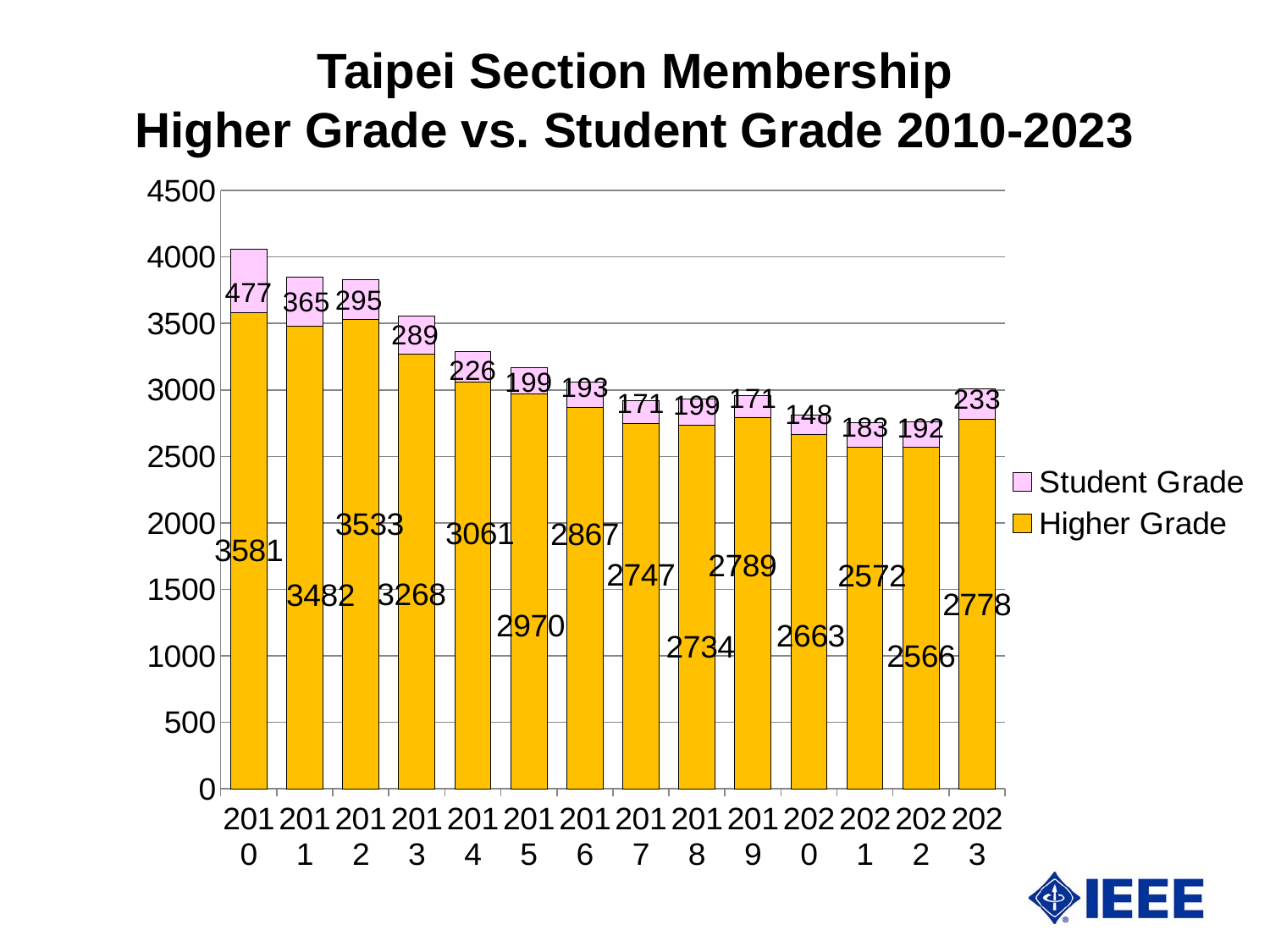
Does the Higher Grade membership rise or fall from 2010 to 2016? Fall What is the total membership (Higher Grade plus Student Grade) for 2023? 3011 Which year has the highest Higher Grade membership? 2010 Is the total height of the 2010 bar greater or less than 4000? greater What kind of chart is shown on the slide? Stacked bar chart How many series does the legend list? 2 Which year has the larger Higher Grade membership, 2018 or 2019? 2019 How many years are shown on the x axis? 14 What is the difference between the Higher Grade membership in 2010 and in 2023? 803 Which year has the lowest Student Grade membership? 2020 What is the Higher Grade membership value for 2010? 3581 What is the Student Grade membership value for 2023? 233